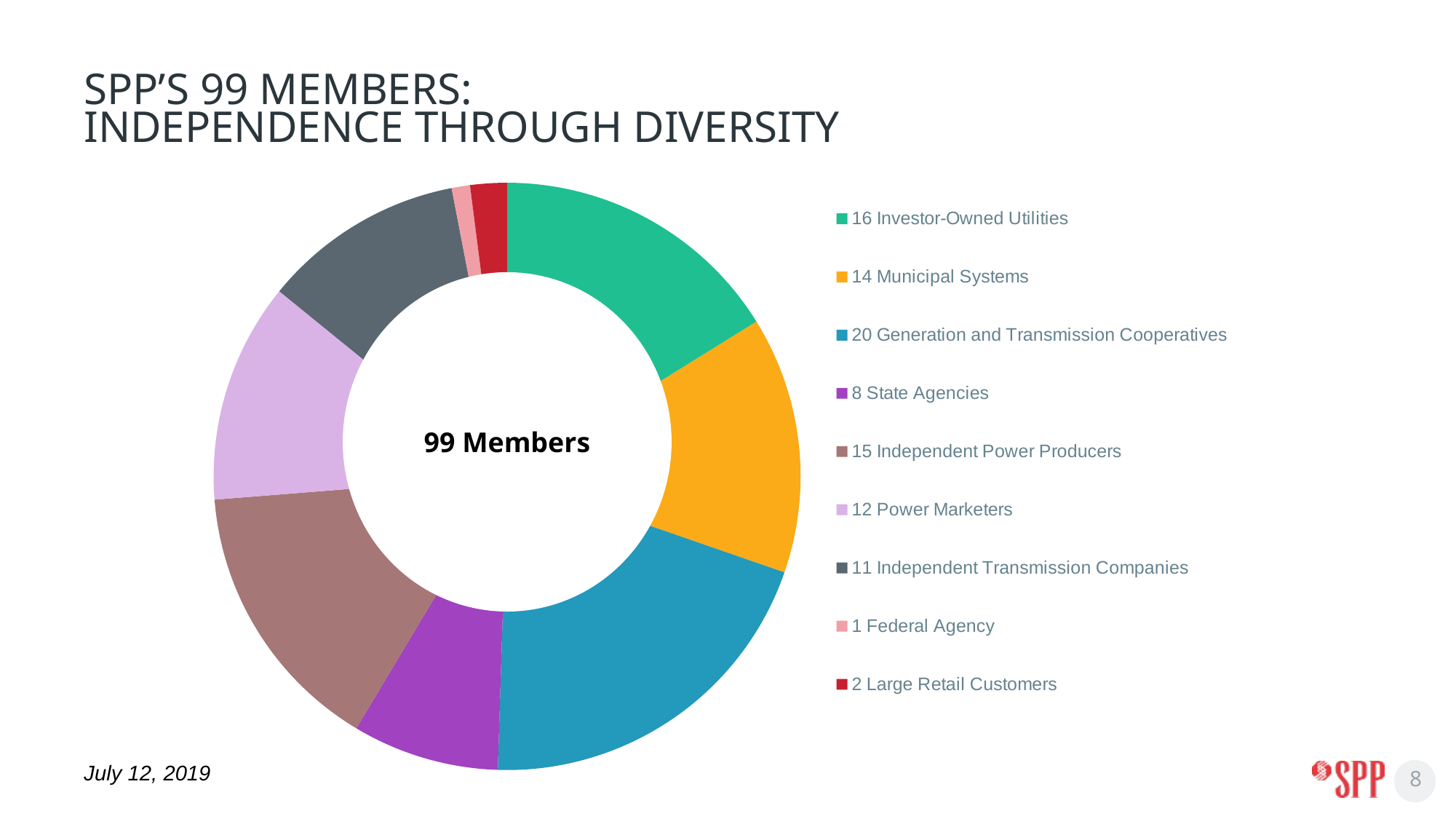
Which category has more members: Municipal Systems or Independent Power Producers? Independent Power Producers What kind of chart is used on this slide? doughnut chart How many member categories does the chart show? 9 How many Municipal Systems are shown in the chart legend? 14 What is the total number of members shown in the centre of the chart? 99 Members How many Generation and Transmission Cooperatives are SPP members according to the chart? 20 How many more Investor-Owned Utilities are there than Power Marketers? 4 How many Independent Transmission Companies are listed in the chart? 11 Which member category has the smallest number of members? Federal Agency What colour represents Large Retail Customers in the chart? red What is the difference between the number of Independent Power Producers and the number of State Agencies? 7 Which member category has the largest number of members? Generation and Transmission Cooperatives